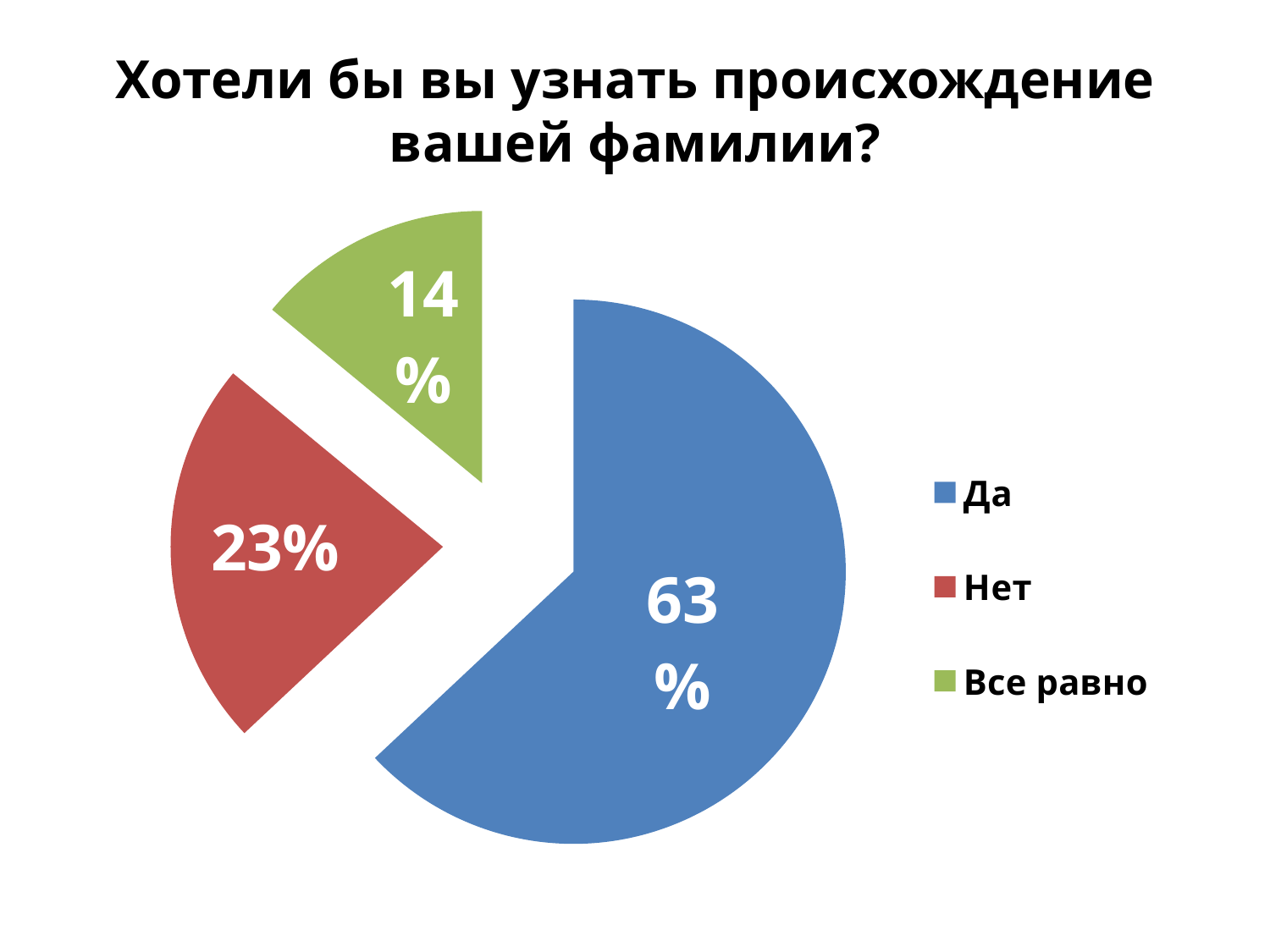
What percentage of respondents answered "Все равно"? 14% How many entries does the legend list? 3 What kind of chart is shown on the slide? pie chart What colour is the slice for "Все равно"? green Which is larger, the share for "Нет" or the share for "Все равно"? Нет What percentage of respondents answered "Нет"? 23% Which answer has the smallest share of the pie? Все равно How many slices does the pie chart have? 3 What is the difference in percentage points between "Нет" and "Все равно"? 9 What percentage of respondents answered "Да"? 63% What is the difference in percentage points between "Да" and "Нет"? 40 Which answer has the largest share of the pie? Да